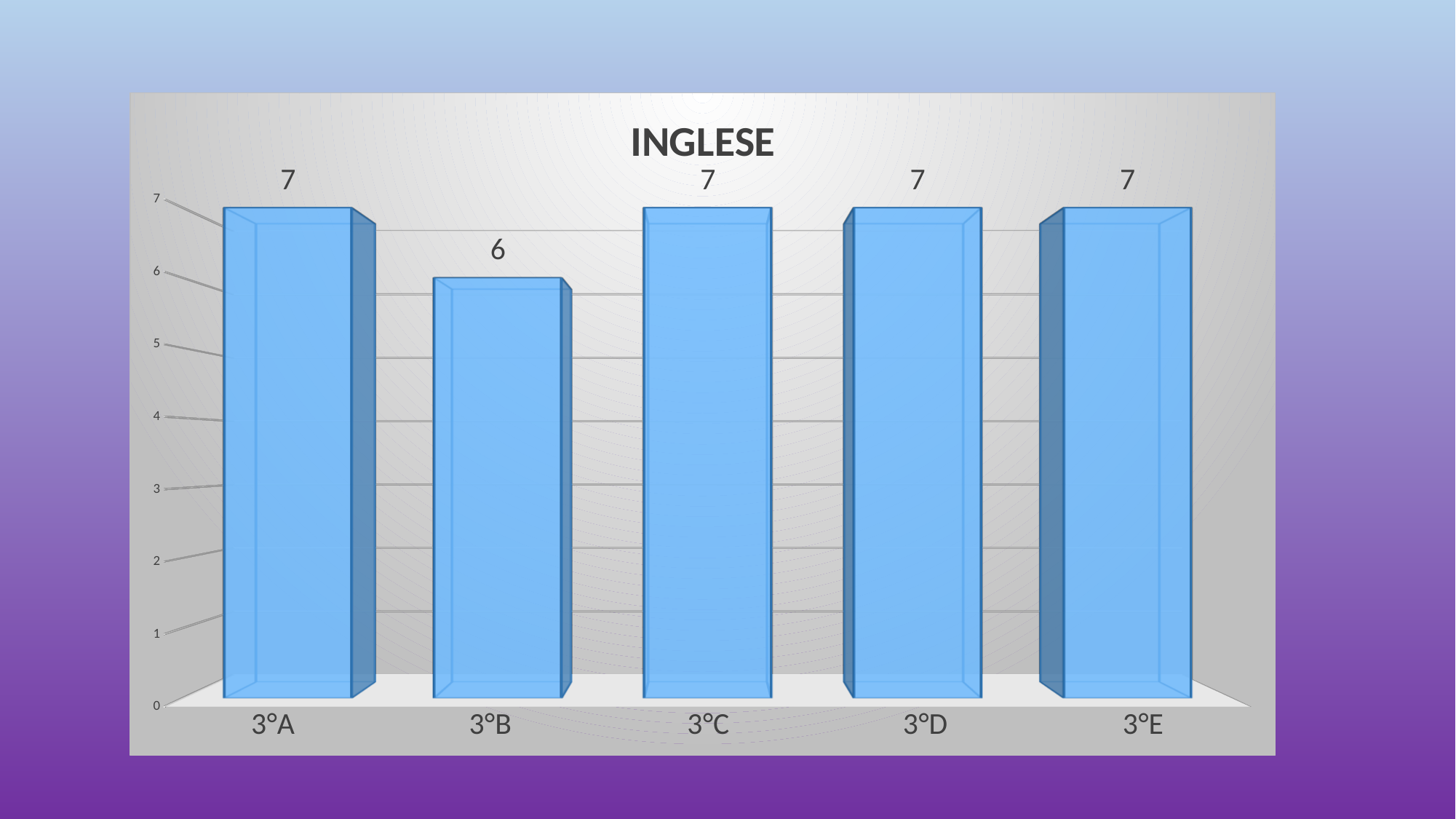
What kind of chart is shown on the slide? bar chart What is the value for 3°E? 7 What is the difference between the values for 3°A and 3°B? 1 What is the value for 3°A? 7 Which is larger, the value for 3°B or the value for 3°D? 3°D What is the value for 3°B? 6 What is the total of the values for 3°A, 3°B, 3°C, 3°D and 3°E? 34 Which category has the lowest value? 3°B How many categories are shown on the x axis? 5 What is the title of the chart? INGLESE Is the value for 3°B greater or less than 7? less What is the value for 3°C? 7